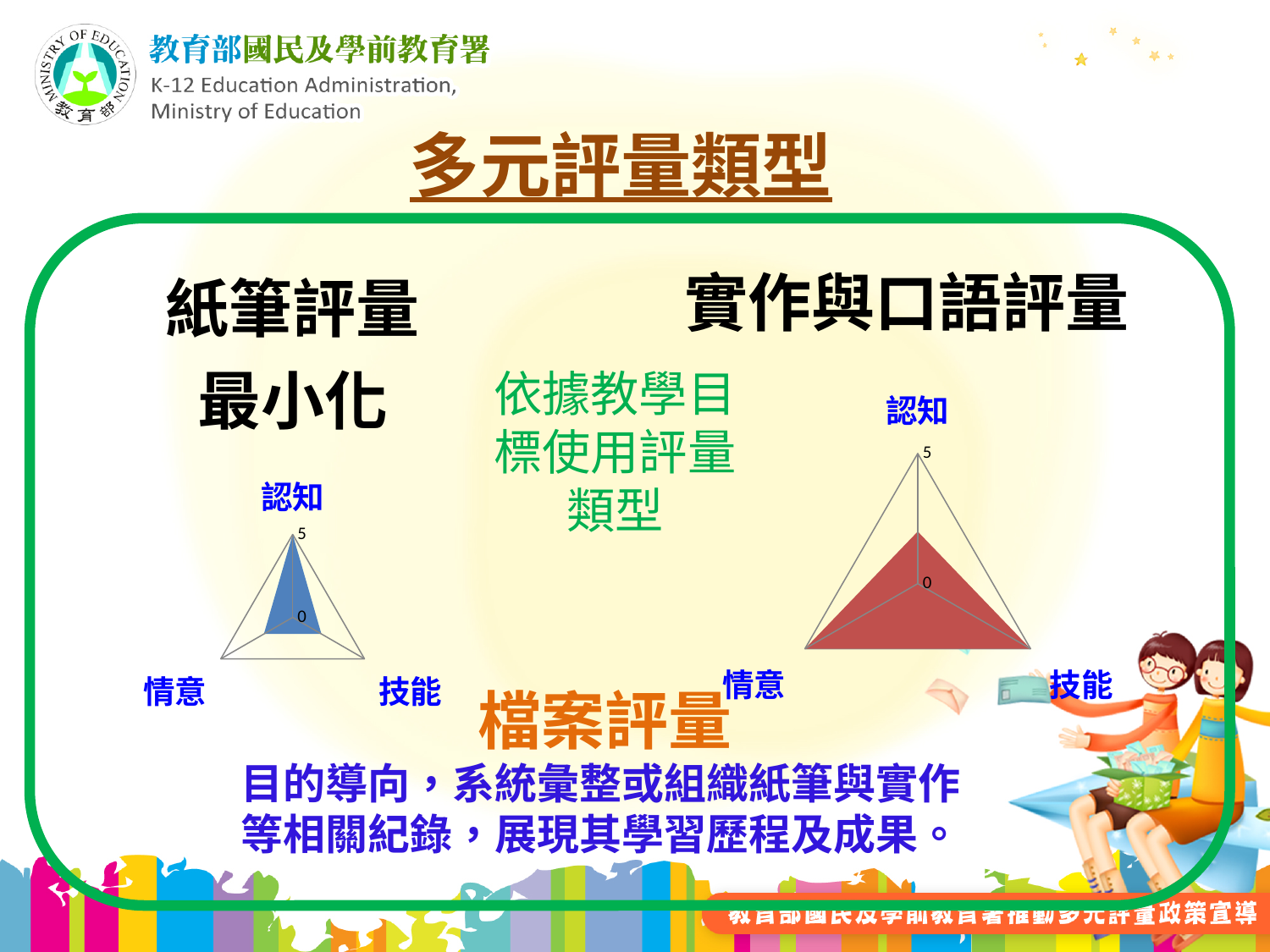
In the left radar chart, which is larger, the value for 認知 or the value for 技能? 認知 In the right radar chart, what is the value for 情意? 5 In the right radar chart, is the value for 認知 greater or less than 5? less In the left radar chart, what is the value for 認知? 5 In the left radar chart, is the value for 情意 greater or less than 5? less In the right radar chart, what is the value for 技能? 5 In the left radar chart, which category has the highest value? 認知 What kind of chart is shown under 實作與口語評量 on the right of the slide? Radar chart In the right radar chart, which category has the lowest value? 認知 What are the three category labels on the right radar chart? 認知, 情意, 技能 What kind of chart is shown under 紙筆評量 on the left of the slide? Radar chart How many axes (categories) does the left radar chart have? 3